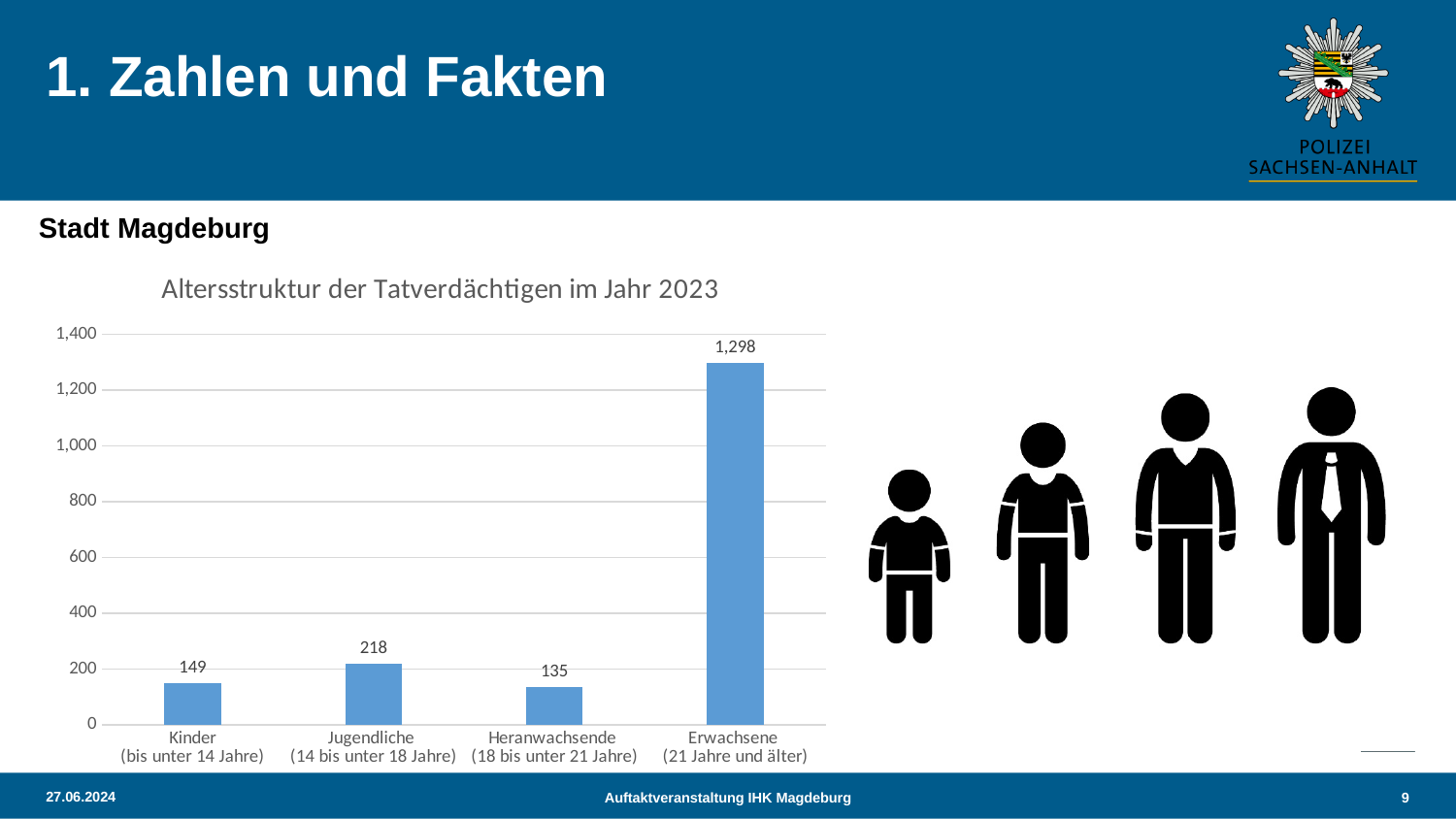
Which age group has the lowest value? Heranwachsende (18 bis unter 21 Jahre) What is the difference between the values for Kinder and Heranwachsende? 14 What is the value for Heranwachsende (18 bis unter 21 Jahre)? 135 Is the value for Erwachsene greater or less than 1,200? greater How many age groups are shown in the chart? 4 What is the value for Jugendliche (14 bis unter 18 Jahre)? 218 Which is larger, the value for Jugendliche or the value for Kinder? Jugendliche What is the title of the chart? Altersstruktur der Tatverdächtigen im Jahr 2023 What is the value for Erwachsene (21 Jahre und älter)? 1,298 Which age group has the highest value? Erwachsene (21 Jahre und älter) What is the value for Kinder (bis unter 14 Jahre)? 149 What is the difference between the values for Erwachsene and Jugendliche? 1,080